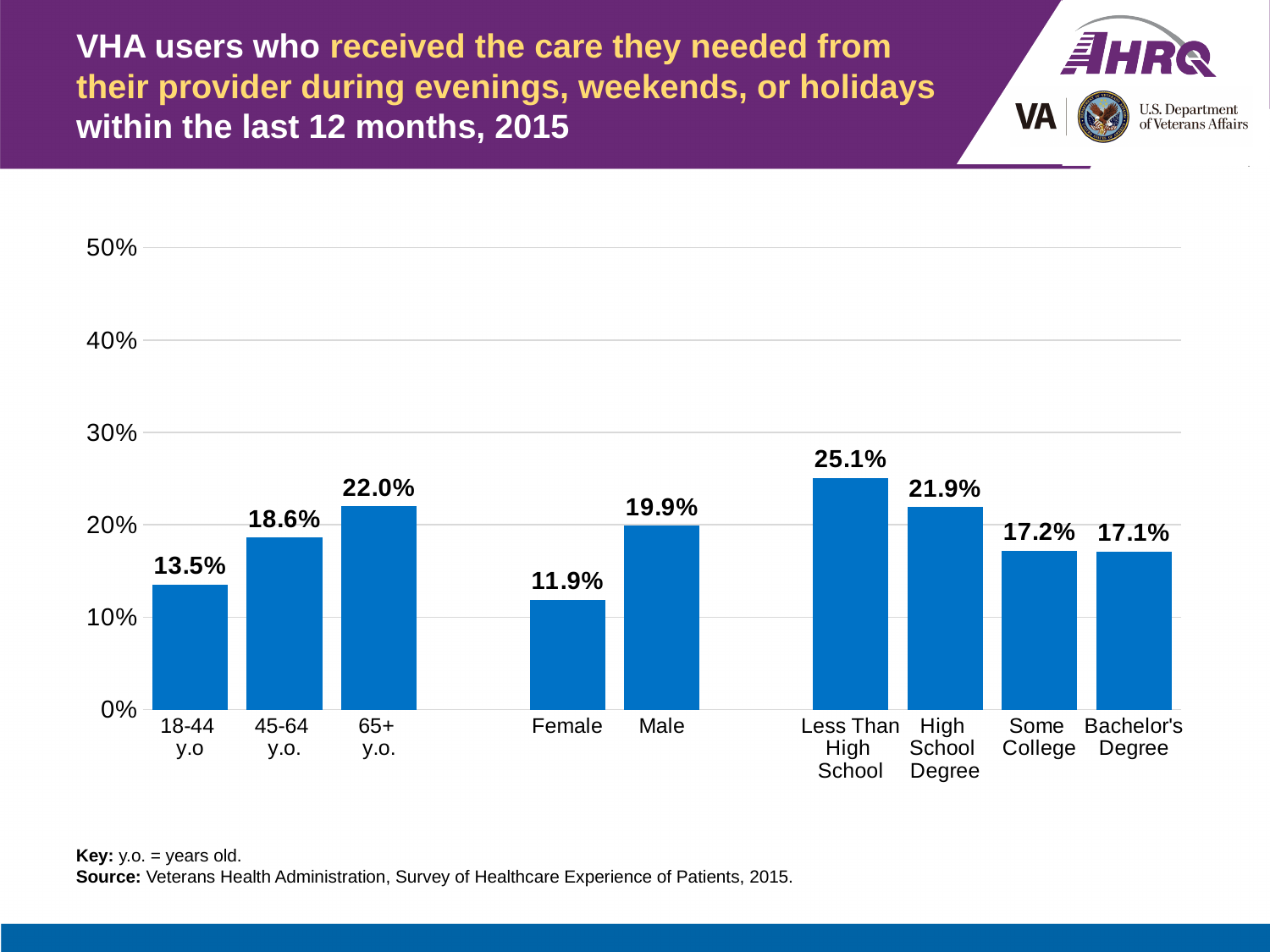
What is the value shown for Female VHA users? 11.9% What is the difference between the values for Male and Female VHA users? 8.0% How many categories are shown on the chart? 9 Which category has the lowest value on the chart? Female Which category has the highest value on the chart? Less Than High School Which is larger, the value for High School Degree or the value for Some College? High School Degree What is the value shown for VHA users with Less Than High School education? 25.1% What is the difference between the values for the 65+ y.o. group and the 18-44 y.o group? 8.5% Is the value for the 45-64 y.o. group greater or less than 20%? less What percentage of VHA users aged 18-44 received the care they needed during evenings, weekends, or holidays? 13.5% What kind of chart is shown on the slide? bar chart What is the value shown for VHA users with a Bachelor's Degree? 17.1%